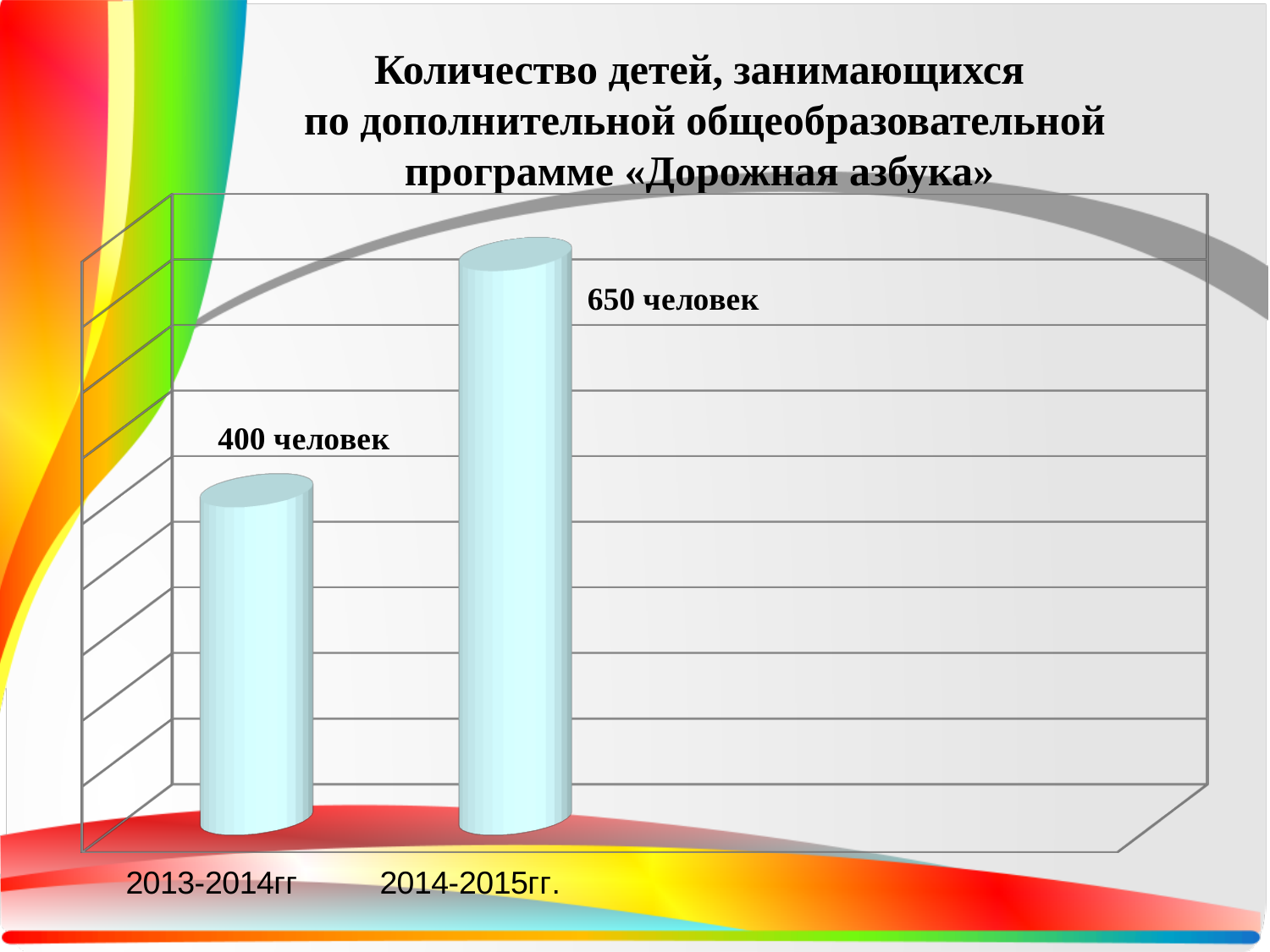
What is the total of the two values shown on the chart? 1050 человек What kind of chart is shown on the slide? bar chart What is the value for 2013-2014гг? 400 человек Which is larger, the value for 2013-2014гг or the value for 2014-2015гг.? 2014-2015гг. What is the title of the chart? Количество детей, занимающихся по дополнительной общеобразовательной программе «Дорожная азбука» How many categories are shown on the chart? 2 Do the values rise or fall from 2013-2014гг to 2014-2015гг.? rise What is the value for 2014-2015гг.? 650 человек What is the difference between the values for 2014-2015гг. and 2013-2014гг? 250 человек Which category has the highest value? 2014-2015гг. Which category has the lowest value? 2013-2014гг